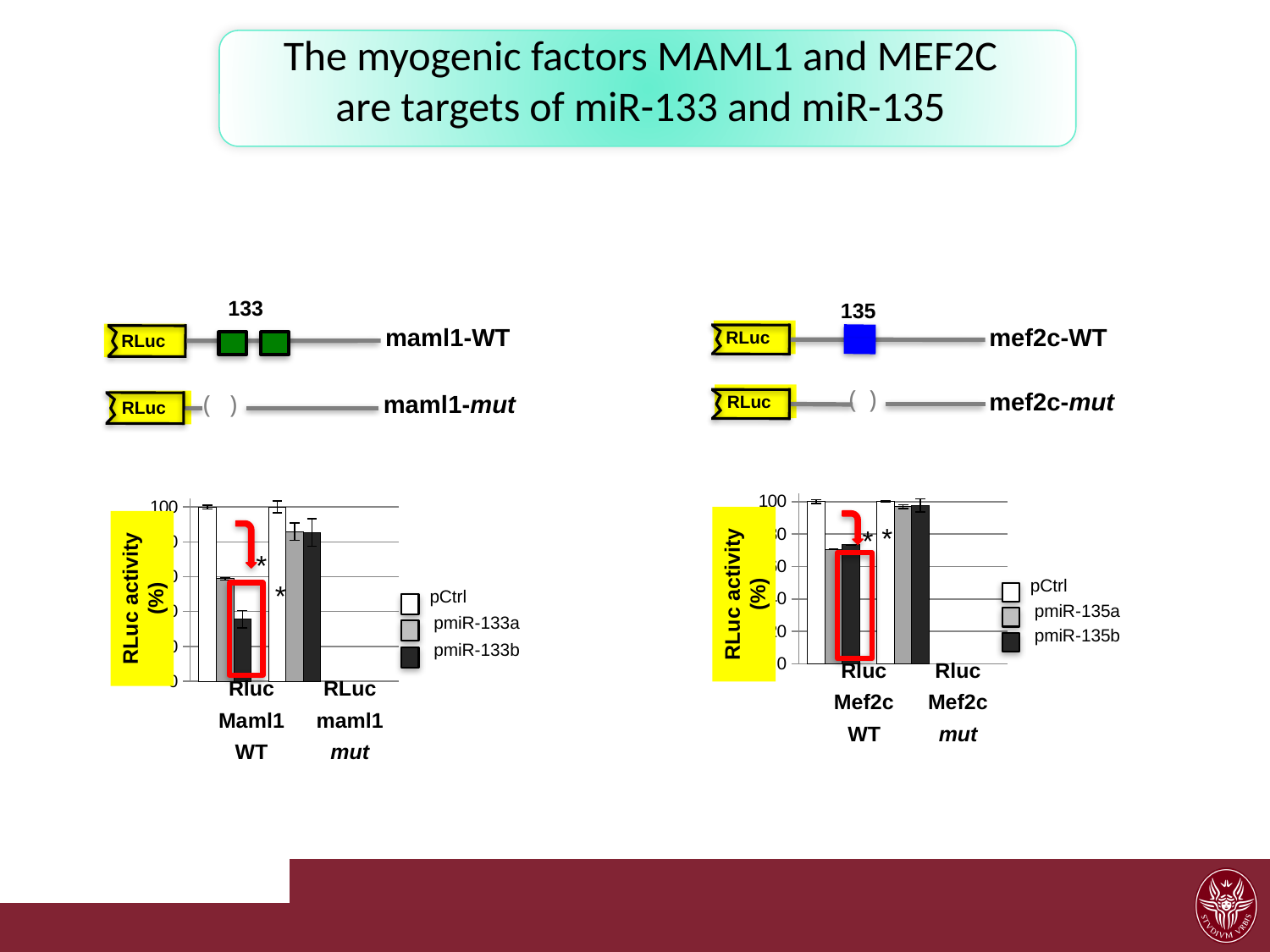
What kind of chart is the left chart (Rluc Maml1)? bar chart In the left chart (Rluc Maml1), is the pmiR-133b value for Rluc Maml1 WT greater or less than 100? less In the right chart (Rluc Mef2c), which series has the highest bar for Rluc Mef2c WT? pCtrl In the right chart (Rluc Mef2c), which is larger for pmiR-135b: Rluc Mef2c WT or Rluc Mef2c mut? Rluc Mef2c mut How many categories are shown on the x axis of the right chart (Rluc Mef2c)? 2 What are the legend entries of the right chart (Rluc Mef2c)? pCtrl, pmiR-135a, pmiR-135b What is the y-axis title of the left chart (Rluc Maml1)? RLuc activity (%) In the right chart (Rluc Mef2c), is the pmiR-135a value for Rluc Mef2c WT greater or less than 100? less In the left chart (Rluc Maml1), which series has the lowest bar for Rluc Maml1 WT? pmiR-133b In the left chart (Rluc Maml1), which is larger for Rluc Maml1 WT: pCtrl or pmiR-133b? pCtrl How many series does the legend of the right chart (Rluc Mef2c) list? 3 How many series does the legend of the left chart (Rluc Maml1) list? 3